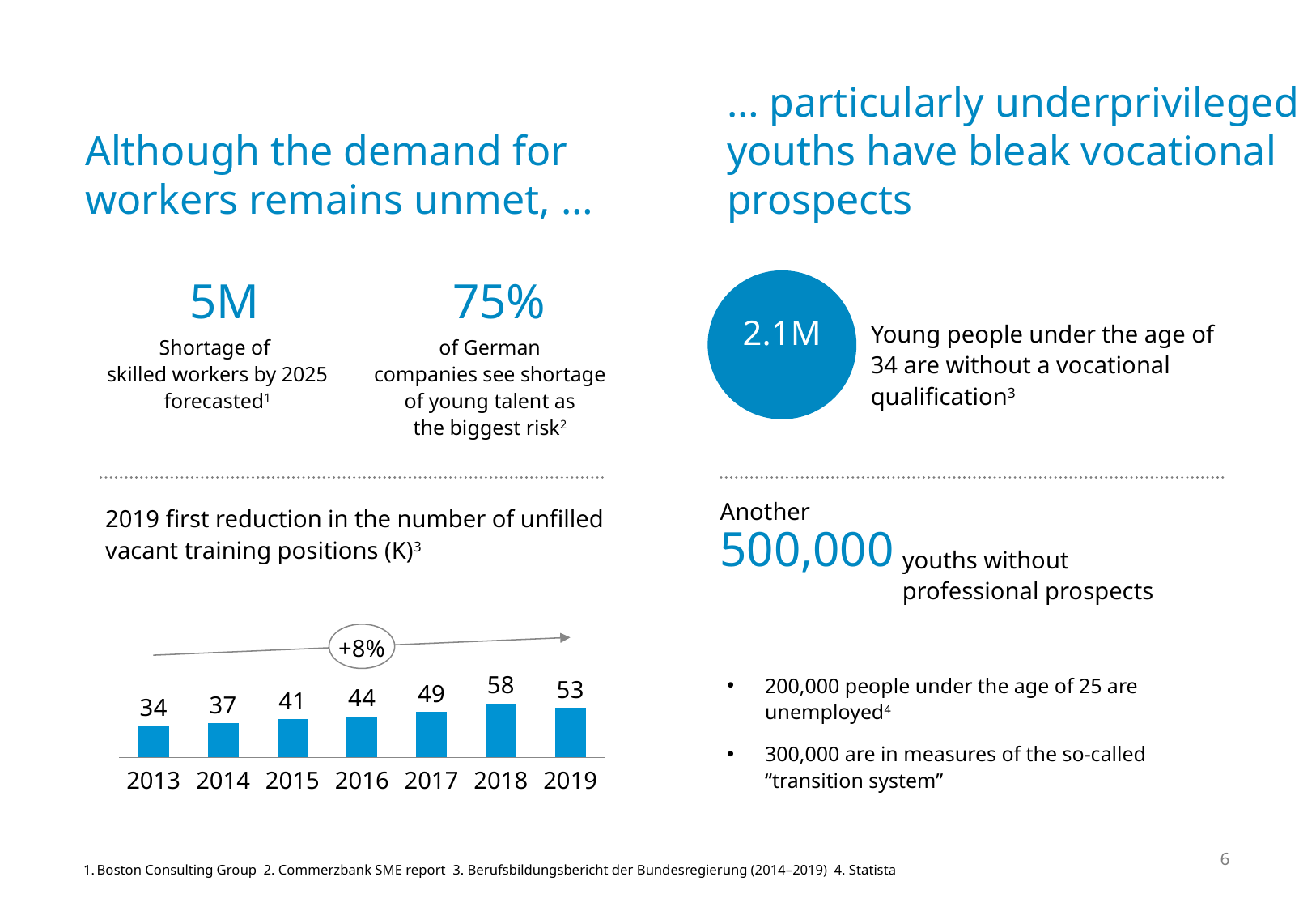
In the chart of unfilled vacant training positions, is the value for 2016 or 2017 larger? 2017 What is the value for 2013 in the chart of unfilled vacant training positions? 34 Which year has the highest number of unfilled vacant training positions in the chart? 2018 What is the value for 2018 in the chart of unfilled vacant training positions? 58 What kind of chart is used to show the unfilled vacant training positions? Bar chart What is the difference between the 2018 and 2019 values in the chart of unfilled vacant training positions? 5 Which year has the lowest number of unfilled vacant training positions in the chart? 2013 What is the difference between the 2013 and 2018 values in the chart of unfilled vacant training positions? 24 How many years are shown in the chart of unfilled vacant training positions? 7 What growth rate is shown in the circle above the bars in the chart of unfilled vacant training positions? +8% What is the value for 2019 in the chart of unfilled vacant training positions? 53 Do the values in the chart of unfilled vacant training positions rise or fall from 2013 to 2018? Rise